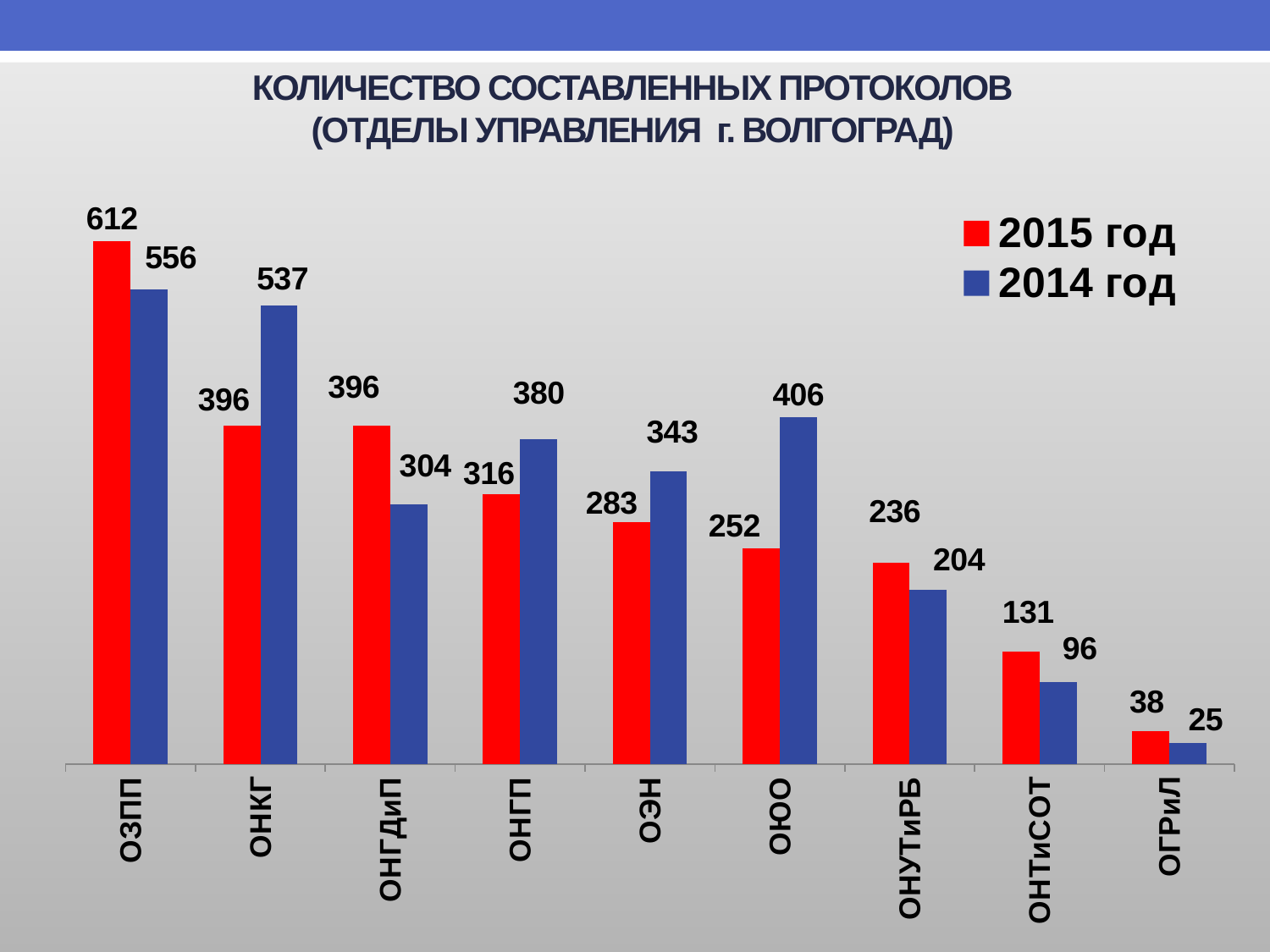
What is the value for ОЗПП in the 2015 год series? 612 What is the difference between the 2015 год and 2014 год values for ОЗПП? 56 What is the value for ОЮО in the 2015 год series? 252 What kind of chart is shown on the slide? Bar chart Which category has the lowest value in the 2014 год series? ОГРиЛ How many categories are shown on the x axis? 9 How many series does the legend list? 2 Which category has the highest value in the 2015 год series? ОЗПП Which colour represents the 2014 год series? Blue What is the difference between the 2015 год and 2014 год values for ОЮО? 154 What is the value for ОНКГ in the 2014 год series? 537 Which is larger for ОНГП: the 2015 год value or the 2014 год value? 2014 год